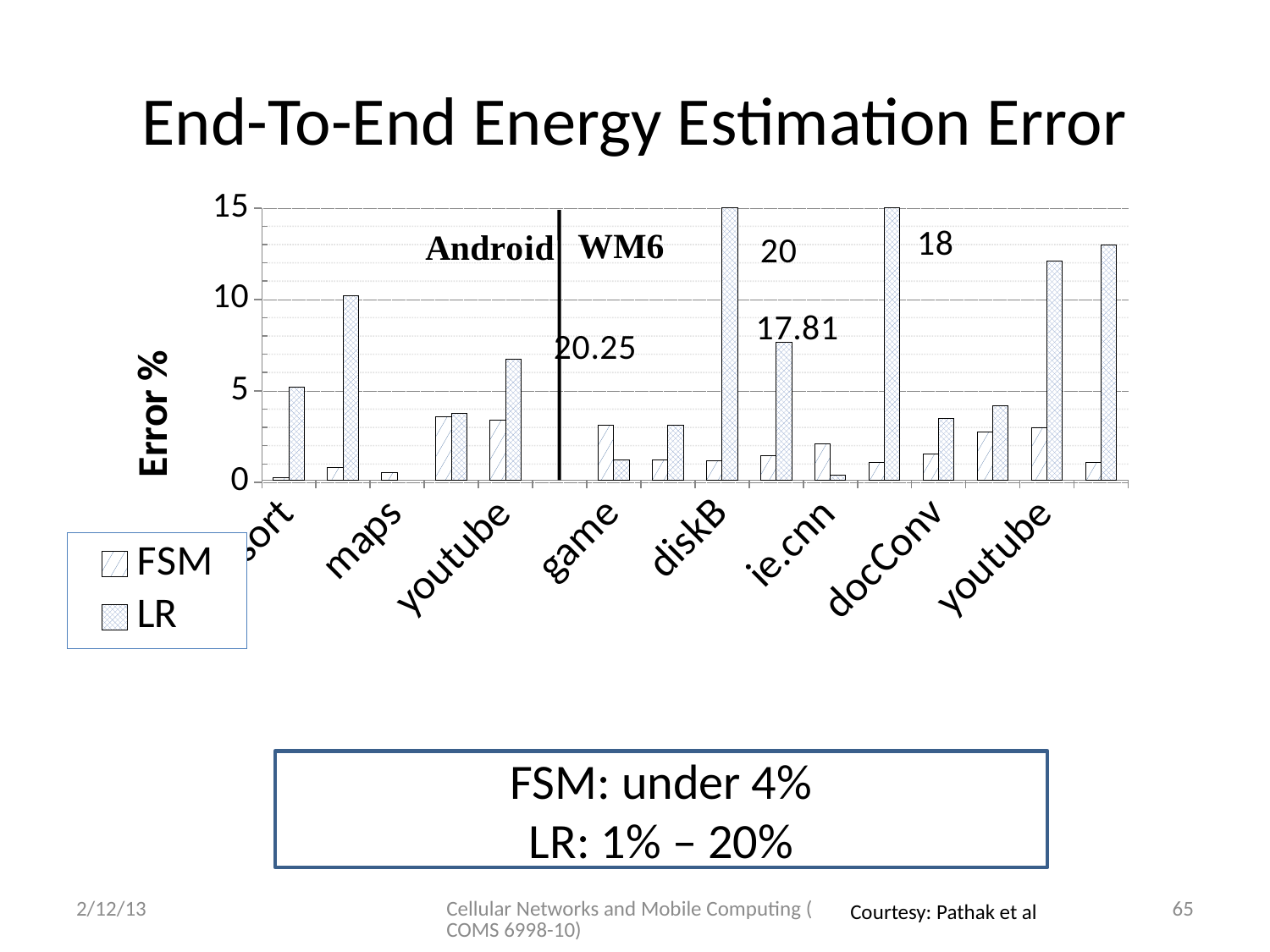
Which series, FSM or LR, has the bars that reach the top of the y axis? LR What kind of chart is shown on the slide? bar chart What is the highest value shown on the y axis? 15 Is the LR value for docConv greater or less than 10? less What is the label on the y axis of the chart? Error % Is the FSM value for diskB greater or less than 5? less Is the LR value for diskB greater or less than 10? greater What are the two series named in the legend? FSM and LR How many series does the legend list? 2 For diskB, which series has the larger value, FSM or LR? LR